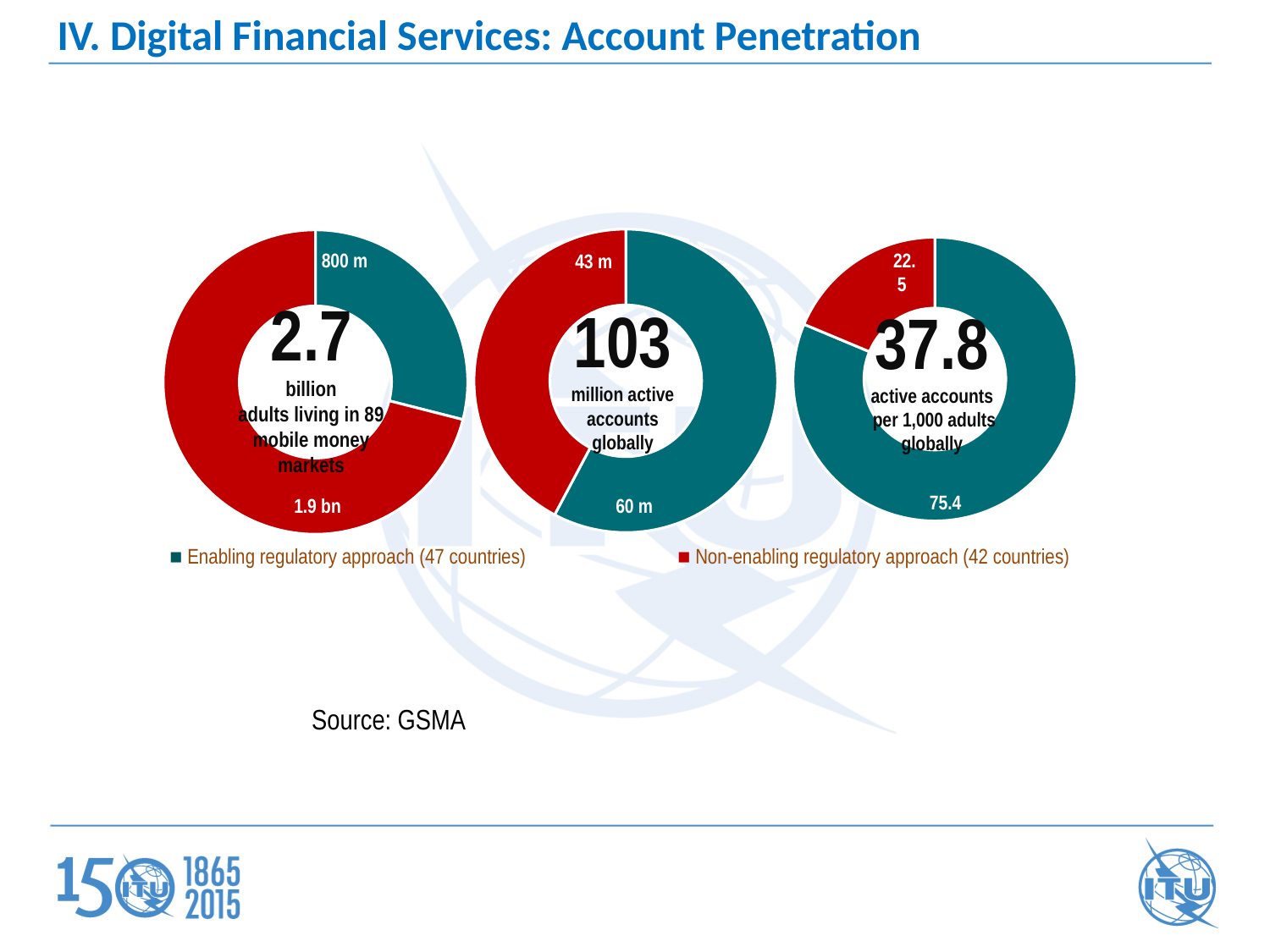
In the left donut chart (2.7 billion adults living in 89 mobile money markets), what is the value for the Enabling regulatory approach segment? 800 m How many series does the legend list for the charts on this slide? 2 In the left donut chart (2.7 billion adults living in 89 mobile money markets), what is the value for the Non-enabling regulatory approach segment? 1.9 bn In the middle donut chart (103 million active accounts globally), what is the value for the Non-enabling regulatory approach segment? 43 m In the middle donut chart (103 million active accounts globally), what is the value for the Enabling regulatory approach segment? 60 m In the right donut chart (37.8 active accounts per 1,000 adults globally), what is the value for the Enabling regulatory approach segment? 75.4 In the middle donut chart (103 million active accounts globally), what is the difference between the Enabling and Non-enabling regulatory approach values? 17 m In the right donut chart (37.8 active accounts per 1,000 adults globally), what is the value for the Non-enabling regulatory approach segment? 22.5 In the left donut chart (2.7 billion adults living in 89 mobile money markets), which segment is larger: Enabling regulatory approach or Non-enabling regulatory approach? Non-enabling regulatory approach In the middle donut chart (103 million active accounts globally), which segment is larger: Enabling regulatory approach or Non-enabling regulatory approach? Enabling regulatory approach In the right donut chart (37.8 active accounts per 1,000 adults globally), what is the difference between the Enabling and Non-enabling regulatory approach values? 52.9 What kind of charts are shown on this slide? Donut (pie) charts